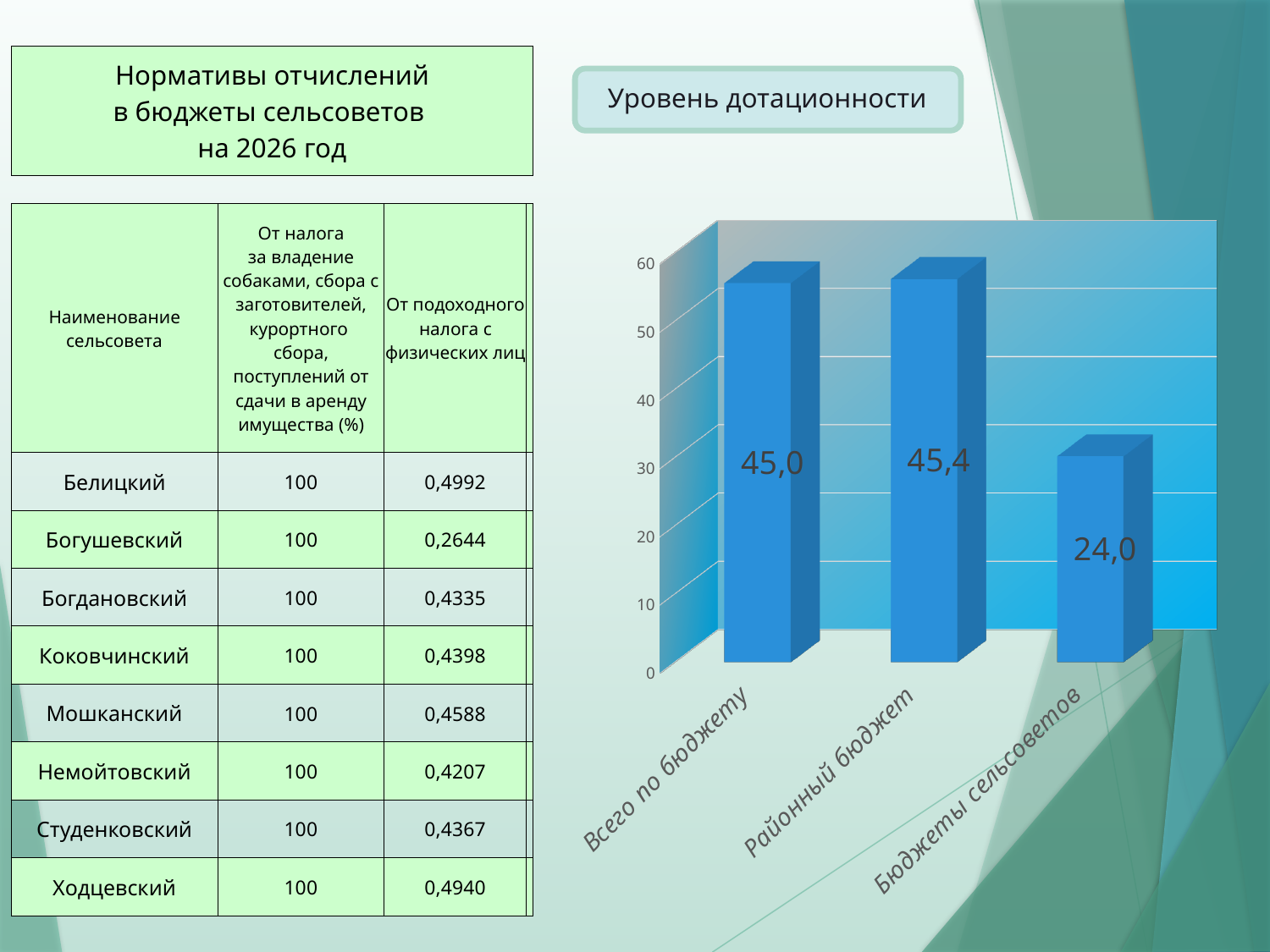
What is the value for Бюджеты сельсоветов in the Уровень дотационности chart? 24,0 Which is larger in the Уровень дотационности chart: Всего по бюджету or Бюджеты сельсоветов? Всего по бюджету Is the value for Районный бюджет in the Уровень дотационности chart greater or less than 40? greater What kind of chart is the Уровень дотационности chart? bar chart What is the difference between the values for Районный бюджет and Бюджеты сельсоветов in the Уровень дотационности chart? 21,4 Which category has the lowest value in the Уровень дотационности chart? Бюджеты сельсоветов What is the difference between the values for Всего по бюджету and Бюджеты сельсоветов in the Уровень дотационности chart? 21,0 How many categories are shown in the Уровень дотационности chart? 3 What is the value for Всего по бюджету in the Уровень дотационности chart? 45,0 What is the value for Районный бюджет in the Уровень дотационности chart? 45,4 Which category has the highest value in the Уровень дотационности chart? Районный бюджет